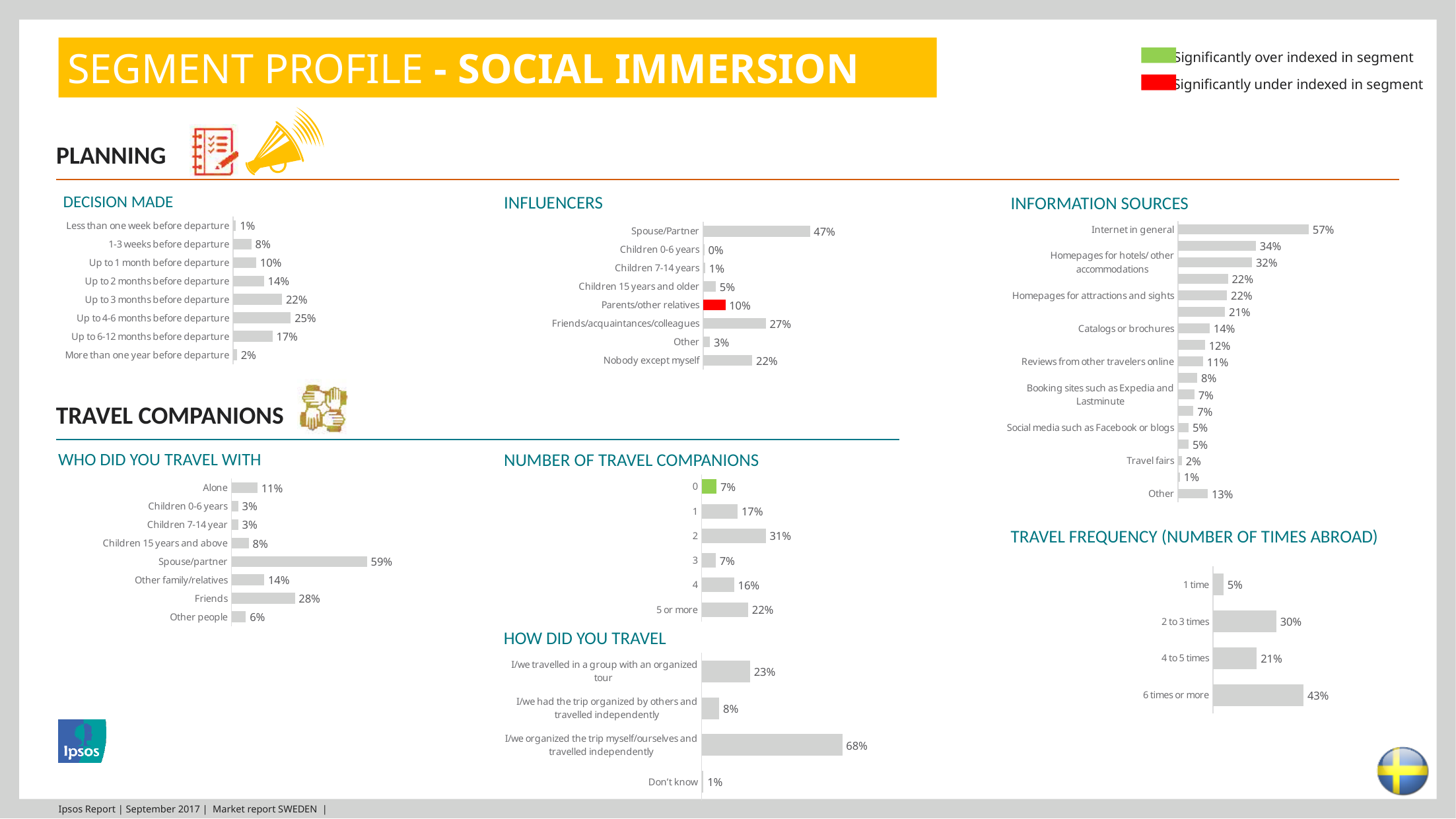
In the NUMBER OF TRAVEL COMPANIONS chart, which category has the highest value? 2 In the INFORMATION SOURCES chart, which is larger: Catalogs or brochures or Reviews from other travelers online? Catalogs or brochures In the DECISION MADE chart, what is the value for 'Up to 4-6 months before departure'? 25% In the TRAVEL FREQUENCY (NUMBER OF TIMES ABROAD) chart, what is the difference between '6 times or more' and '2 to 3 times'? 13% In the INFLUENCERS chart, what is the difference between Friends/acquaintances/colleagues and Nobody except myself? 5% In the HOW DID YOU TRAVEL chart, what is the value for 'I/we organized the trip myself/ourselves and travelled independently'? 68% In the DECISION MADE chart, which category has the highest value? Up to 4-6 months before departure In the INFORMATION SOURCES chart, what is the value for Internet in general? 57% In the INFLUENCERS chart, which category has the lowest value? Children 0-6 years In the WHO DID YOU TRAVEL WITH chart, what is the value for Friends? 28% In the INFLUENCERS chart, what is the value for Spouse/Partner? 47% How many categories does the WHO DID YOU TRAVEL WITH chart show? 8